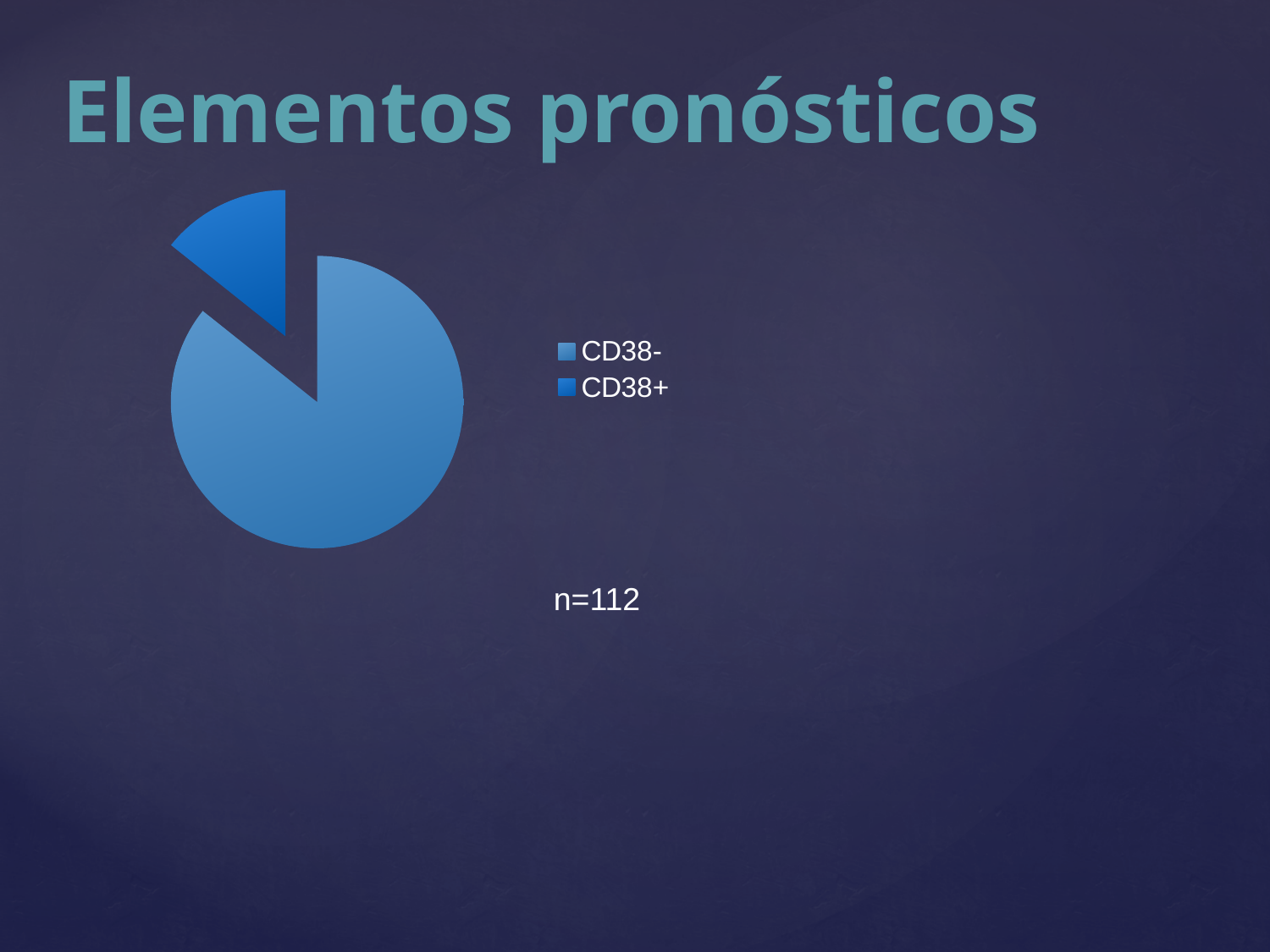
How many entries does the legend of the pie chart list? 2 How many slices does the pie chart have? 2 Which category has the largest slice in the pie chart? CD38- Which slice is larger in the pie chart, CD38- or CD38+? CD38- Which category has the smallest slice in the pie chart? CD38+ What sample size is stated next to the pie chart? n=112 What are the two categories listed in the legend of the pie chart? CD38- and CD38+ What kind of chart is shown on the slide? pie chart